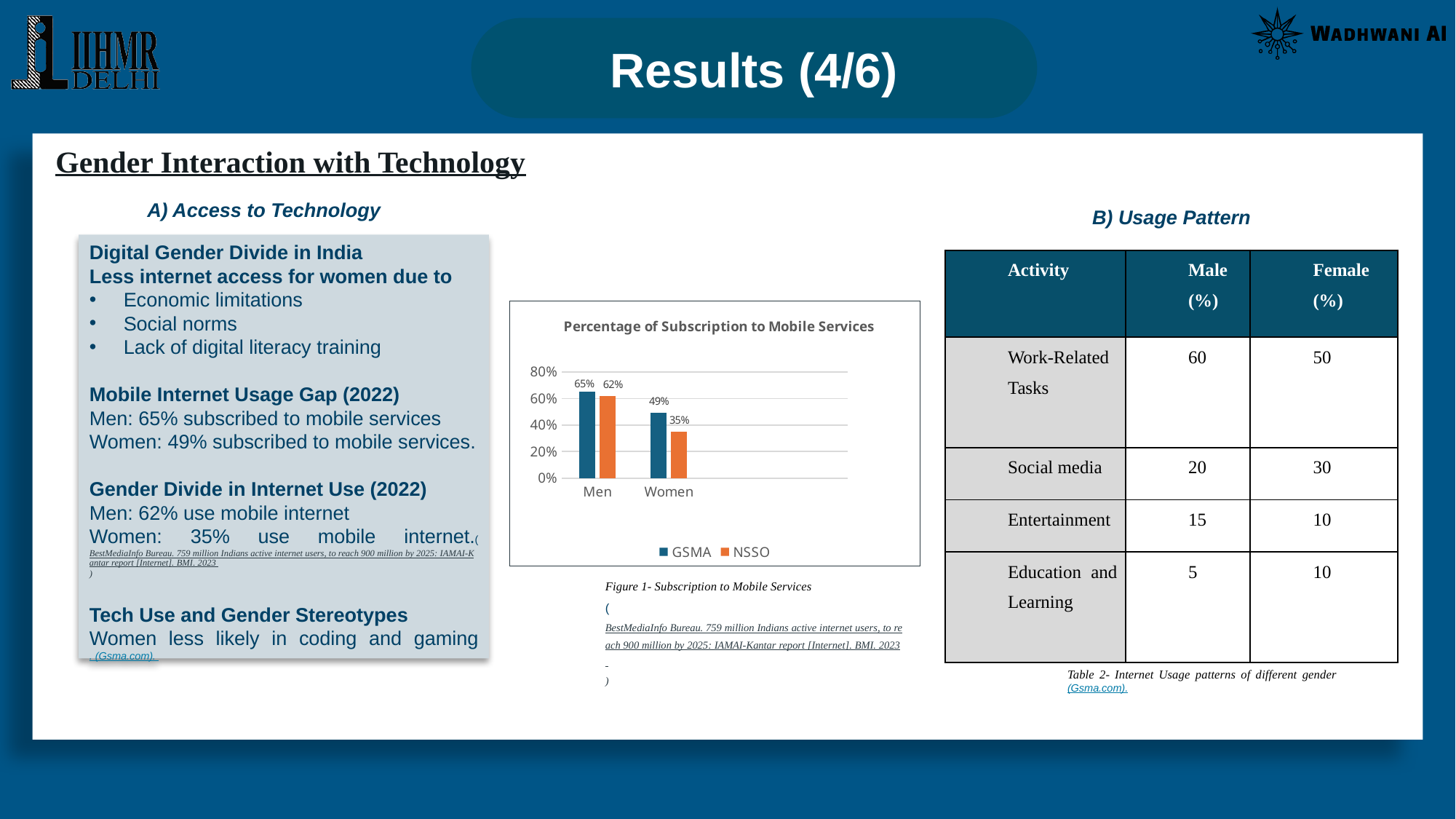
What is the GSMA value for Men in the chart? 65% Which category has the highest GSMA value? Men What is the difference between the NSSO values for Men and Women? 27% What type of chart is shown on the slide? Bar chart How many series does the legend list? 2 What is the GSMA value for Women in the chart? 49% Which is larger for Women: the GSMA value or the NSSO value? GSMA What is the NSSO value for Women in the chart? 35% Which category has the lowest NSSO value? Women What is the title of the chart? Percentage of Subscription to Mobile Services What is the difference between the GSMA values for Men and Women? 16% What is the NSSO value for Men in the chart? 62%